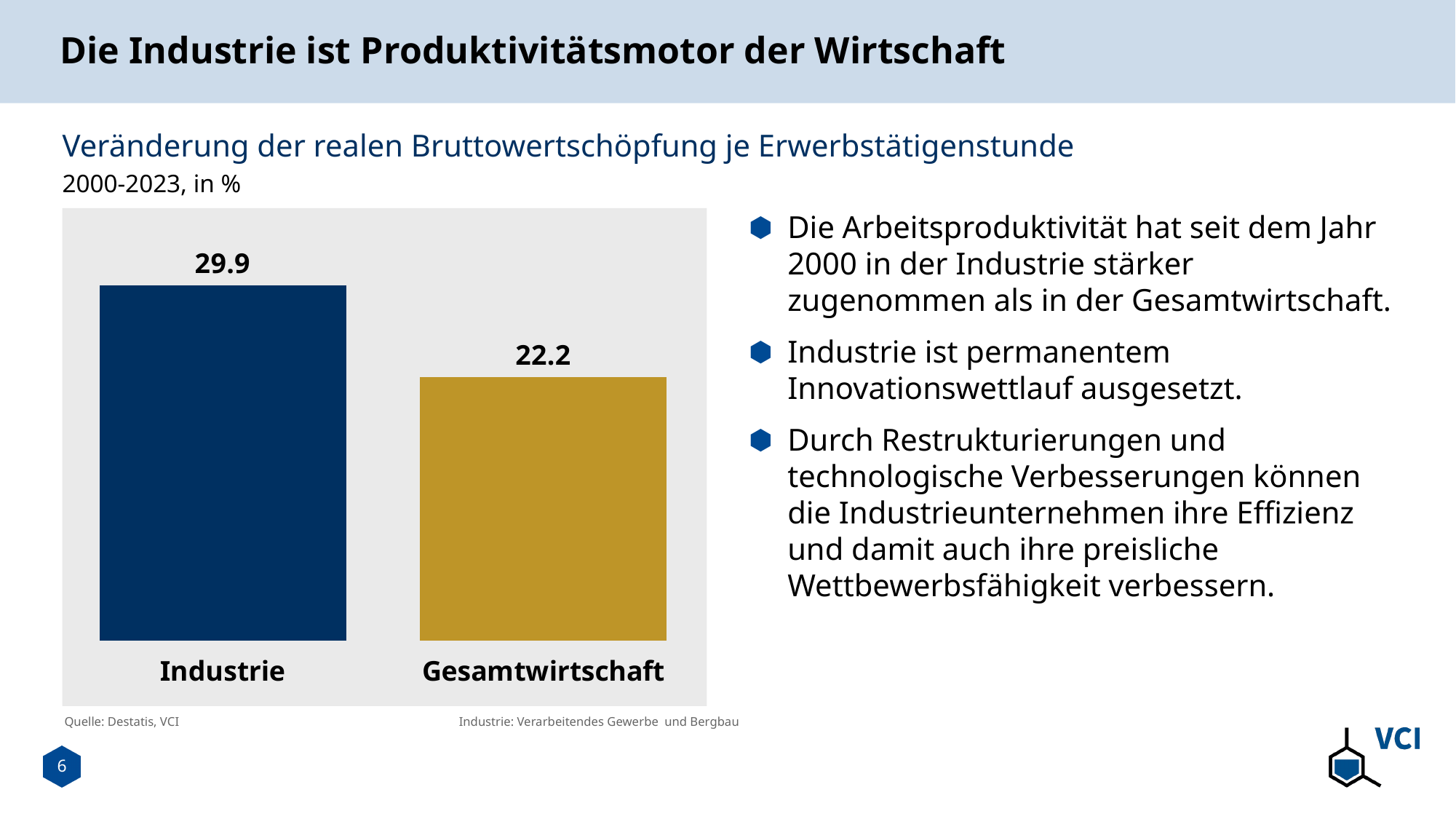
What is the value for Gesamtwirtschaft? 22.2 How many categories are shown in the chart? 2 What is the difference between the values for Industrie and Gesamtwirtschaft? 7.7 What is the value for Industrie? 29.9 What kind of chart is shown on the slide? Bar chart What is the title of the chart? Veränderung der realen Bruttowertschöpfung je Erwerbstätigenstunde What period and unit does the chart subtitle state? 2000-2023, in % Which category has the lowest value? Gesamtwirtschaft Which is larger, the value for Industrie or the value for Gesamtwirtschaft? Industrie Which category has the highest value? Industrie